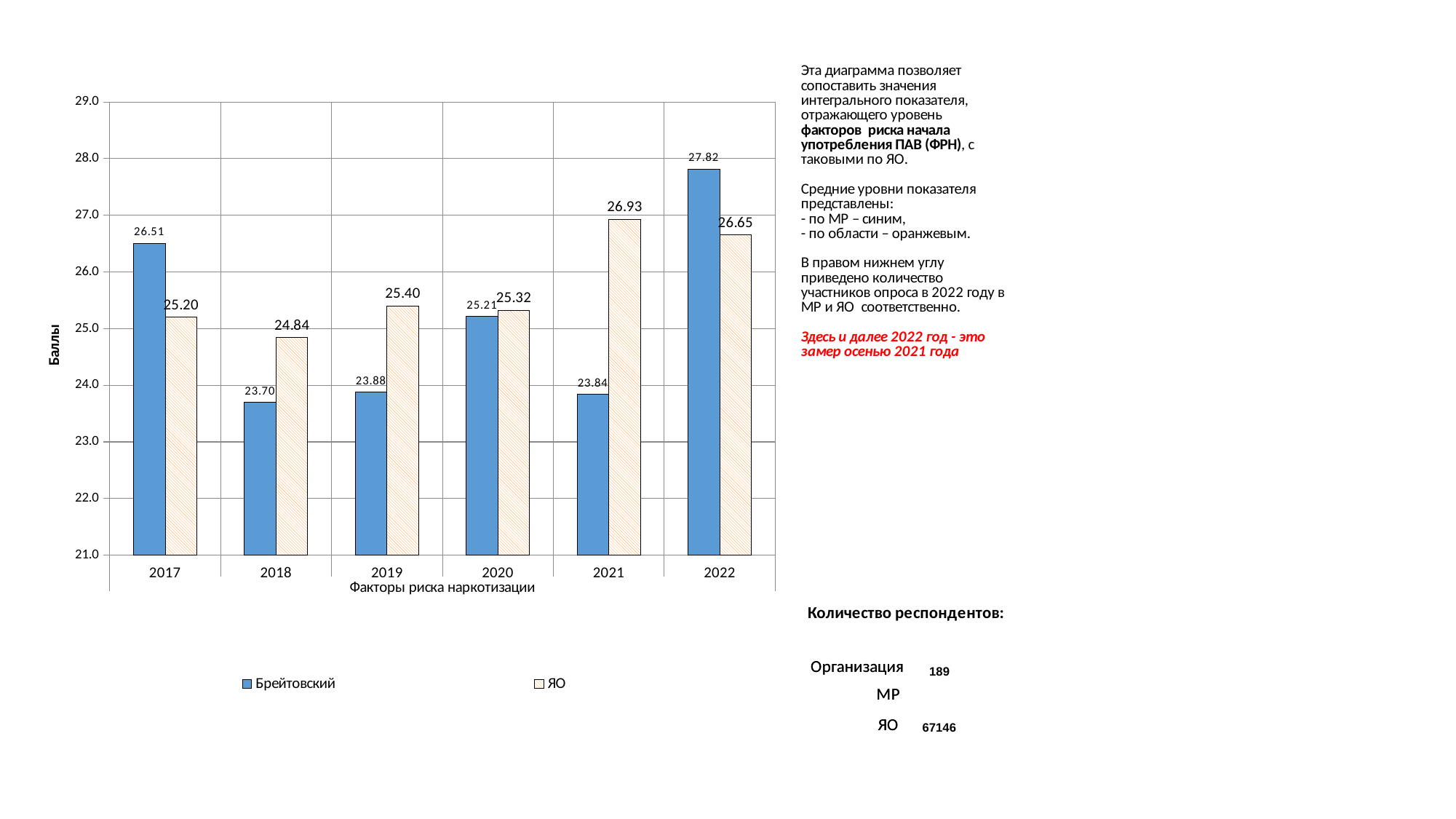
What is the value for Брейтовский in 2017? 26.51 What is the difference between the Брейтовский and ЯО values in 2022? 1.17 What is the value for Брейтовский in 2020? 25.21 Is the Брейтовский value for 2021 greater or less than 24.0? less What is the value for ЯО in 2021? 26.93 In which year is the ЯО value lowest? 2018 In which year is the Брейтовский value lowest? 2018 How many series does the legend list? 2 What kind of chart is shown on the slide? bar chart In which year is the Брейтовский value highest? 2022 How many years are shown on the x axis? 6 Which is larger in 2019, the Брейтовский value or the ЯО value? ЯО